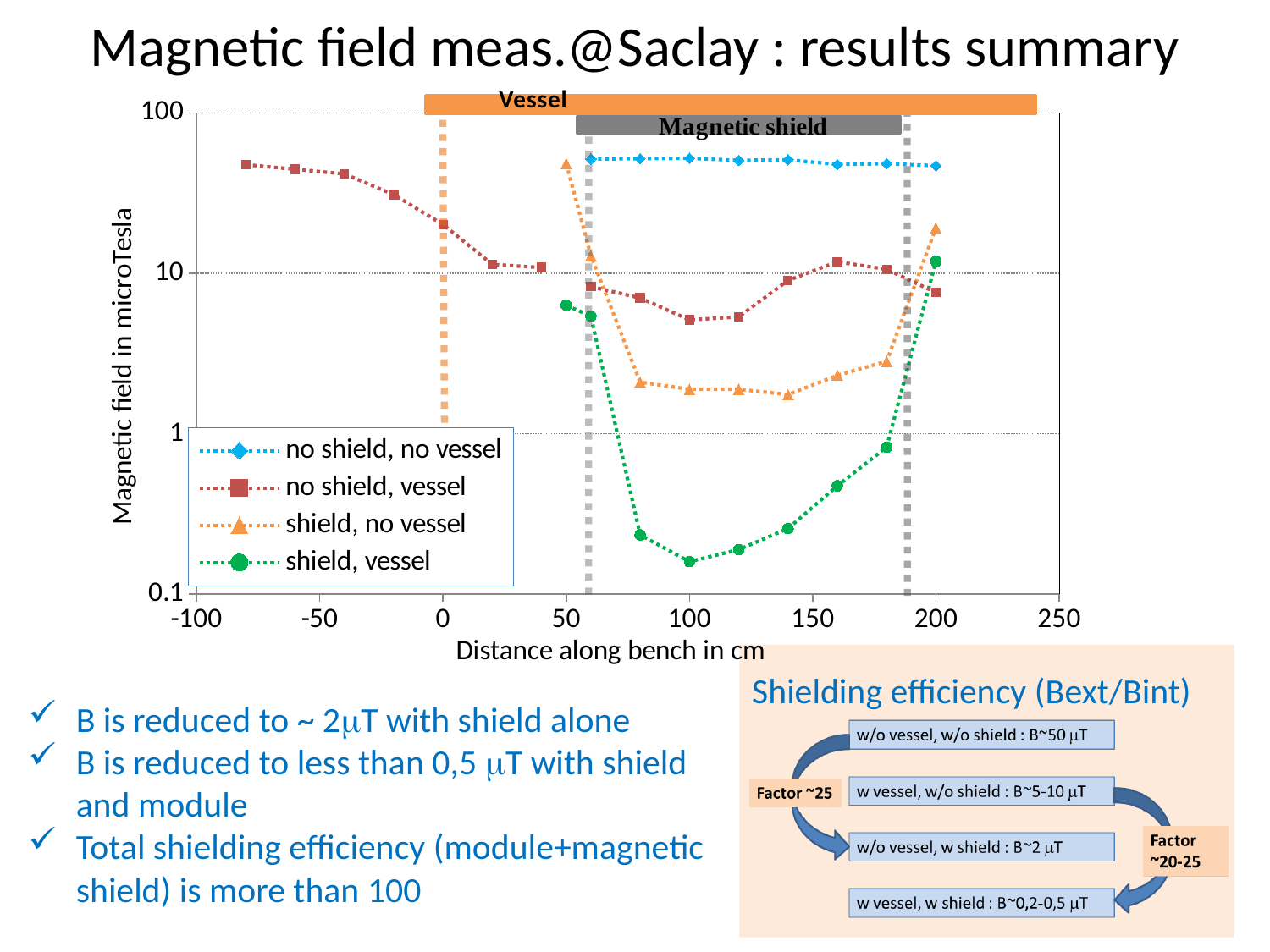
Is the value of the 'no shield, no vessel' series at 100 cm greater or less than 10? greater Which series has the lowest value at 100 cm? shield, vessel What is the label of the x axis of the chart? Distance along bench in cm What kind of chart is shown on the slide? line chart At 100 cm, which series has the higher value: 'no shield, no vessel' or 'shield, vessel'? no shield, no vessel Is the value of the 'no shield, vessel' series at 200 cm greater or less than 10? less Is the value of the 'no shield, vessel' series at -80 cm greater or less than 10? greater Does the 'no shield, vessel' series rise or fall between -80 cm and 0 cm? fall What is the label of the y axis of the chart? Magnetic field in microTesla How many series does the chart legend list? 4